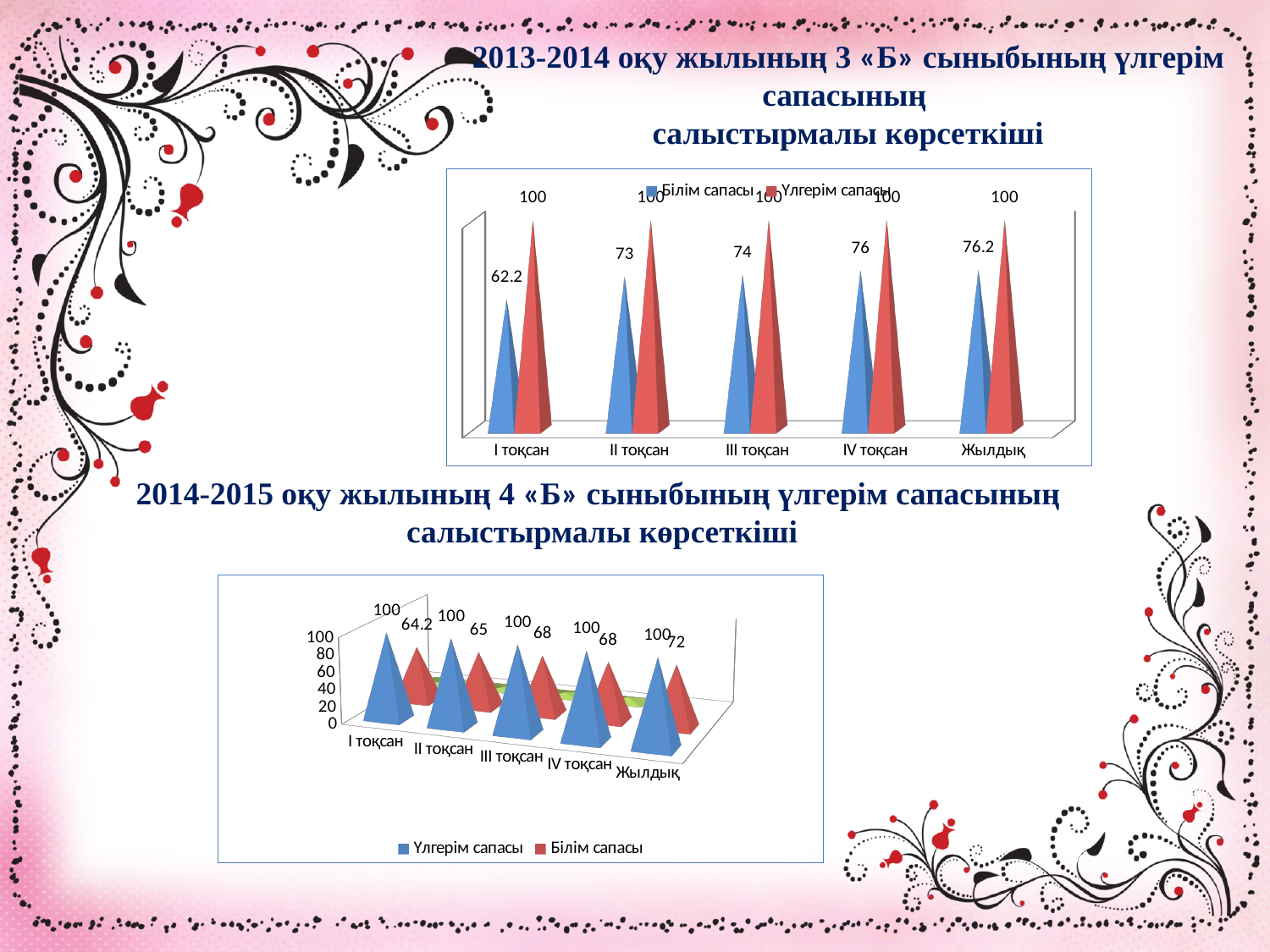
In the bottom chart, which category has the highest Білім сапасы value? Жылдық In the top chart, what is the difference between the Үлгерім сапасы and Білім сапасы values for II тоқсан? 27 In the top chart, what is the value of Білім сапасы for Жылдық? 76.2 In the top chart, what is the value of Білім сапасы for I тоқсан? 62.2 In the top chart, which category has the lowest Білім сапасы value? I тоқсан In the top chart, does the Білім сапасы value rise or fall from I тоқсан to Жылдық? rise In the bottom chart, how many series does the legend list? 2 In the bottom chart, which is larger for III тоқсан: Үлгерім сапасы or Білім сапасы? Үлгерім сапасы In the bottom chart, what is the value of Білім сапасы for I тоқсан? 64.2 In the top chart, how many categories are shown on the x axis? 5 What kind of chart is the bottom chart? bar chart In the bottom chart, what is the value of Білім сапасы for Жылдық? 72